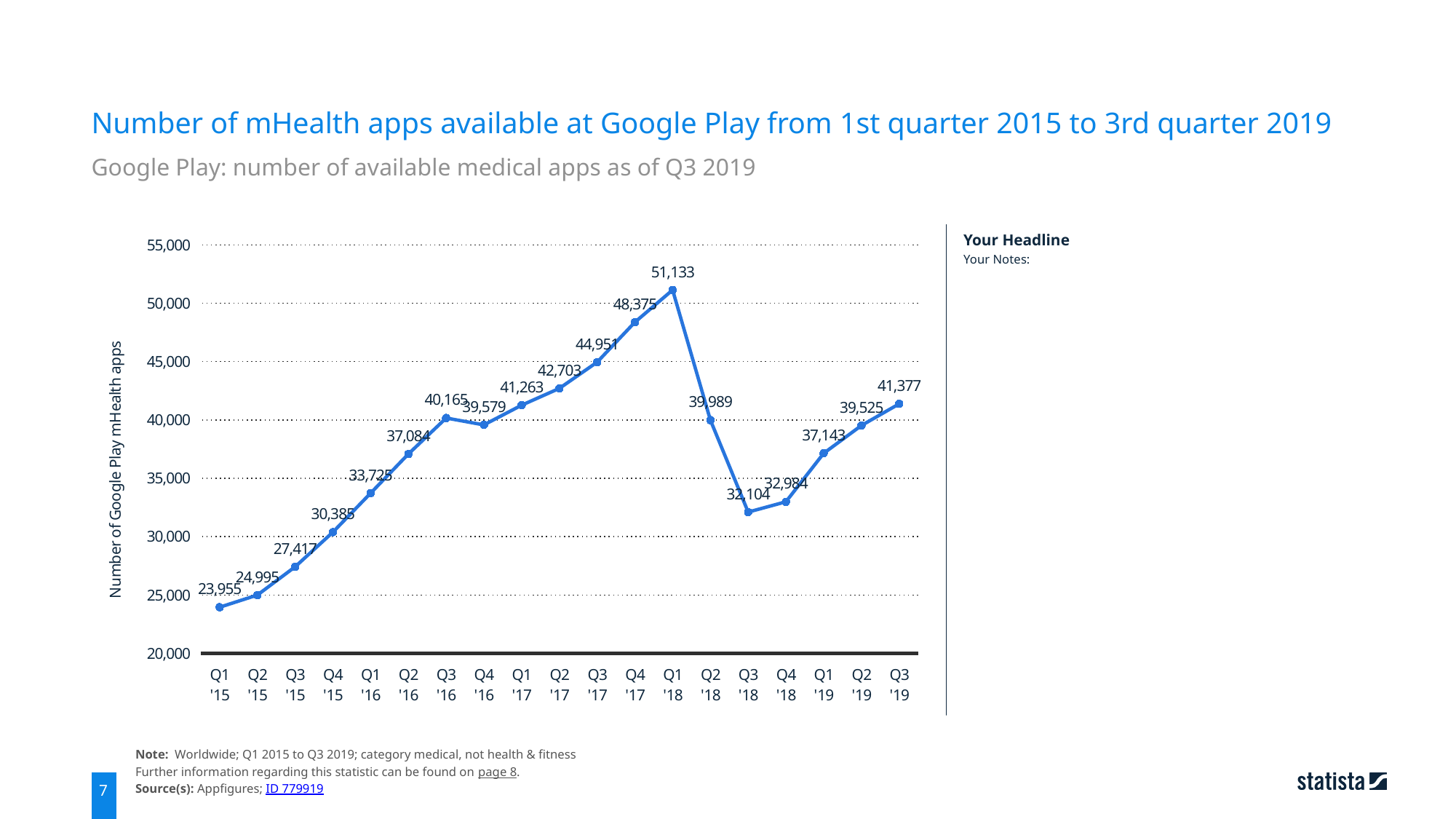
Is the number of mHealth apps in Q4 '17 greater or less than 45,000? greater What is the number of Google Play mHealth apps in Q3 '19? 41,377 What is the number of Google Play mHealth apps in Q1 '18? 51,133 What is the difference between the number of mHealth apps in Q1 '18 and Q2 '18? 11,144 How many quarters are plotted on the chart? 19 What is the difference between the number of mHealth apps in Q3 '19 and Q1 '15? 17,422 Which quarter has more mHealth apps, Q3 '16 or Q4 '16? Q3 '16 What kind of chart is shown on the slide? line chart Does the number of mHealth apps rise or fall from Q1 '15 to Q1 '18? rise What is the number of Google Play mHealth apps in Q3 '18? 32,104 Which quarter has the highest number of Google Play mHealth apps? Q1 '18 Which quarter has the lowest number of Google Play mHealth apps? Q1 '15